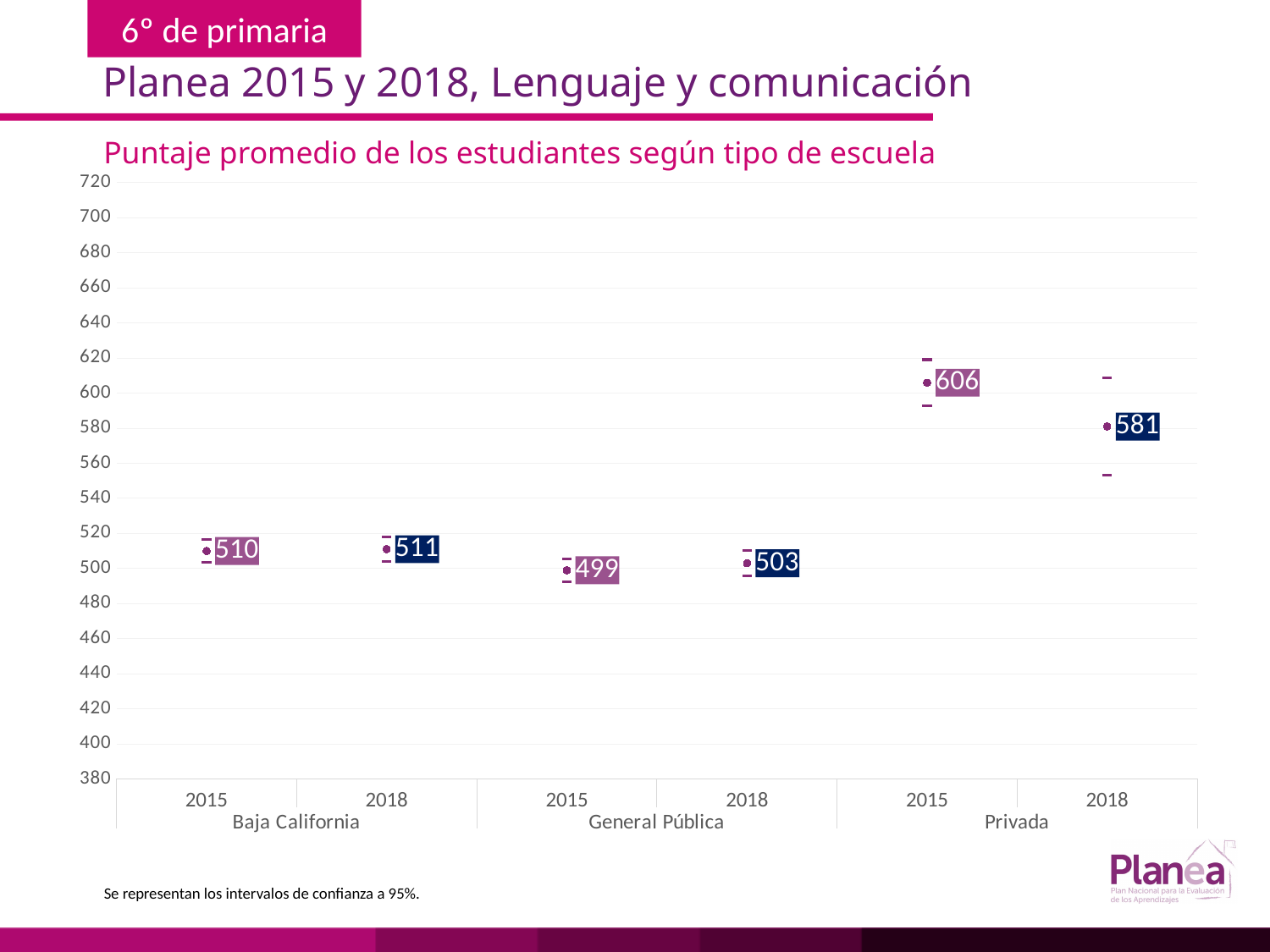
What is the title of the chart? Puntaje promedio de los estudiantes según tipo de escuela What is the difference between the Privada scores in 2015 and 2018? 25 What is the difference between the General Pública scores in 2018 and 2015? 4 How many data points are plotted on the chart? 6 Did the Privada score rise or fall from 2015 to 2018? fall Which is larger, the Privada score in 2015 or the Baja California score in 2018? Privada 2015 What is the average score for Privada schools in 2018? 581 Is the Privada score in 2018 greater or less than 600? less What is the average score for Baja California in 2015? 510 Which school type and year has the lowest average score? General Pública, 2015 Which school type and year has the highest average score? Privada, 2015 What is the average score for General Pública schools in 2015? 499